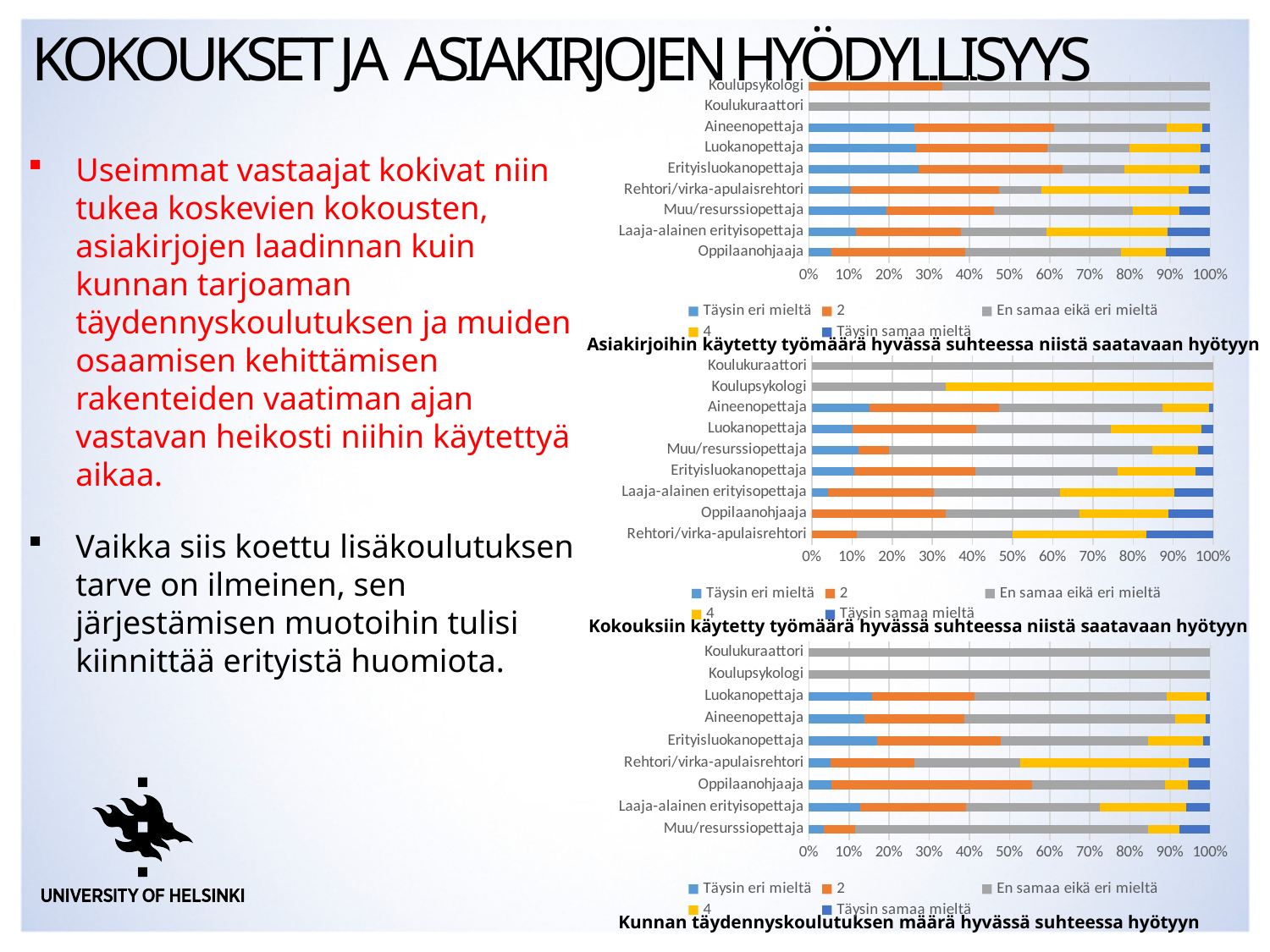
In the middle chart, is the '4' segment for Koulupsykologi greater or less than 50%? greater In the top chart, which has the larger 'Täysin eri mieltä' segment, Aineenopettaja or Oppilaanohjaaja? Aineenopettaja How many series does the legend of the top chart list? 5 How many respondent categories are shown in the middle chart? 9 In the bottom chart, is the '4' segment for Rehtori/virka-apulaisrehtori greater or less than 30%? greater In the top chart, is the 'Täysin eri mieltä' segment for Aineenopettaja greater or less than 20%? greater In the middle chart, which has the larger 'En samaa eikä eri mieltä' segment, Koulukuraattori or Koulupsykologi? Koulukuraattori What kind of chart is the top chart on the slide? Stacked bar chart Which legend entry in the bottom chart is shown in gray? En samaa eikä eri mieltä How many respondent categories are shown in the bottom chart? 9 What is the highest value shown on the x axis of the bottom chart? 100%